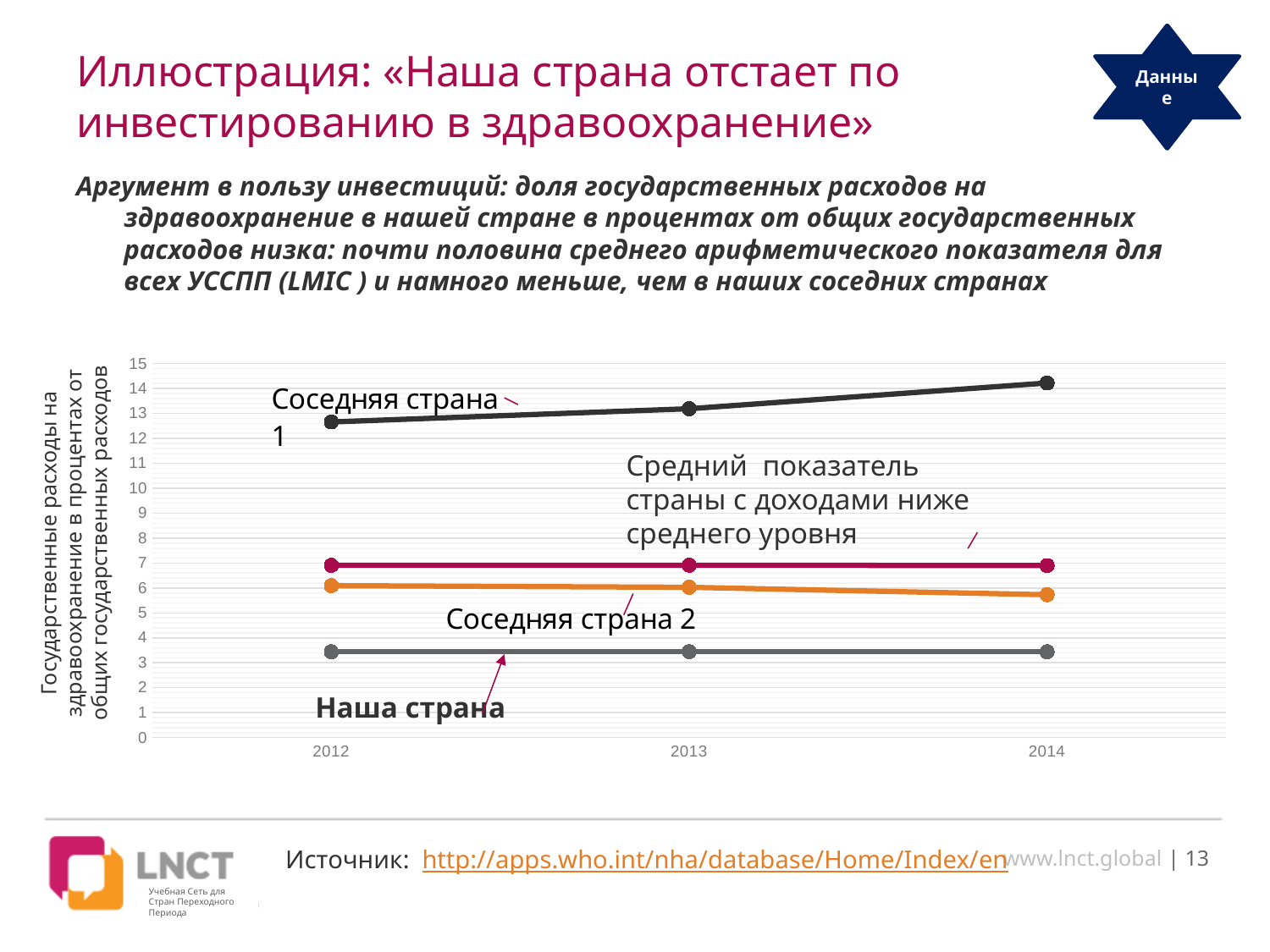
Is the value for Соседняя страна 1 in 2012 greater or less than 12? greater Is the value for Соседняя страна 2 in 2012 greater or less than 5? greater Which years are shown on the x axis of the chart? 2012, 2013, 2014 What kind of chart is shown on the slide? line chart In 2014, which is larger: the value for Соседняя страна 2 or the value for Наша страна? Соседняя страна 2 Is the value for Соседняя страна 1 in 2014 greater or less than 14? greater Does the line for Соседняя страна 2 rise or fall from 2012 to 2014? fall How many years are shown on the x axis of the chart? 3 Which line has the highest values across all years: Соседняя страна 1, Соседняя страна 2, or Наша страна? Соседняя страна 1 Does the line for Соседняя страна 1 rise or fall from 2012 to 2014? rise Which line has the lowest values across all years? Наша страна